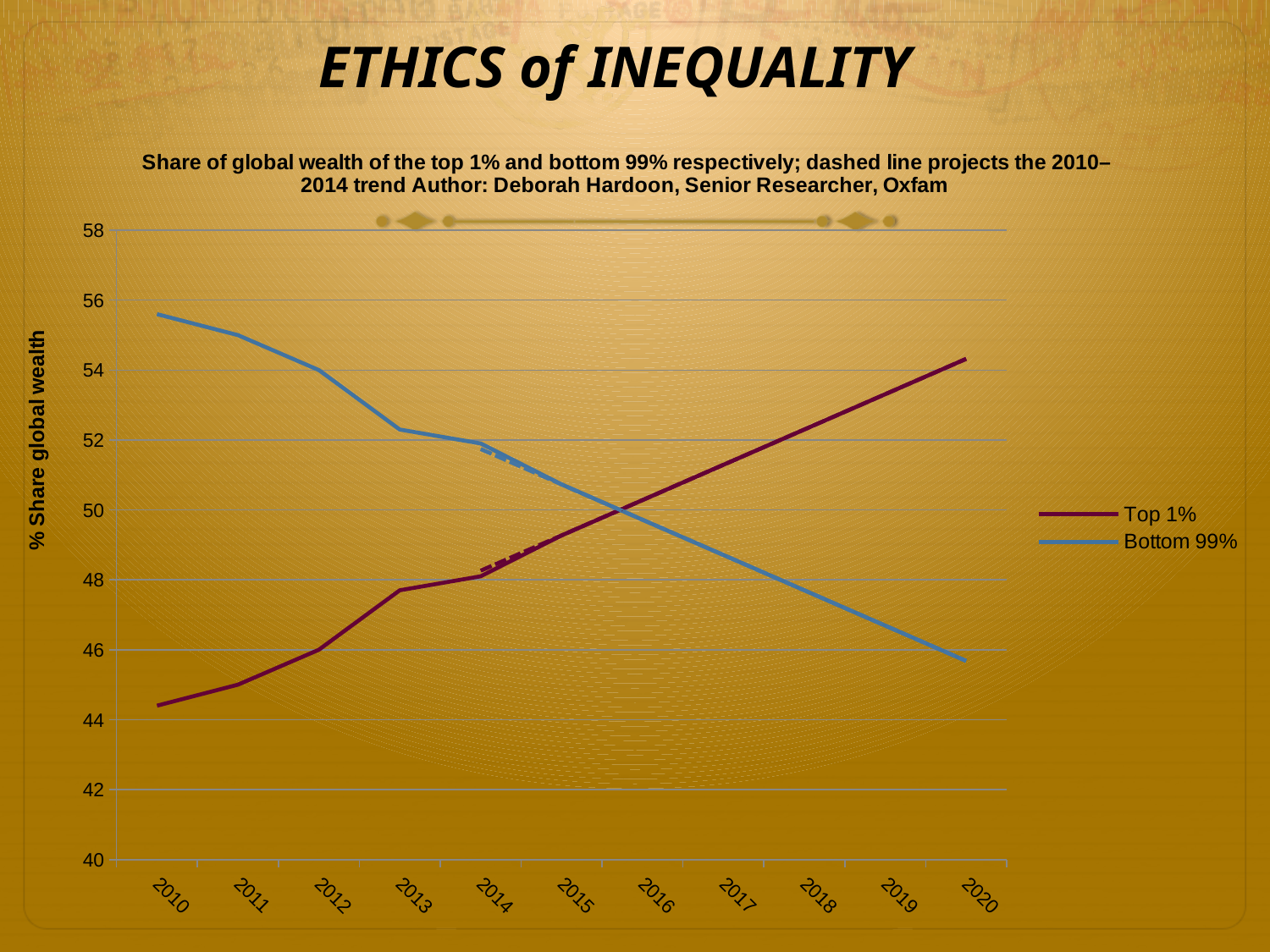
In 2010, which series has the larger value, Top 1% or Bottom 99%? Bottom 99% What kind of chart is shown on the slide? line chart How many series does the legend list? 2 In 2020, which series has the larger value, Top 1% or Bottom 99%? Top 1% Is the value for Bottom 99% in 2010 greater or less than 54? greater Is the value for Top 1% in 2020 greater or less than 52? greater Does the Bottom 99% line rise or fall from 2010 to 2020? fall Is the value for Top 1% in 2010 greater or less than 46? less What is the title of the vertical axis? % Share global wealth Does the Top 1% line rise or fall from 2010 to 2020? rise How many years are shown on the x axis? 11